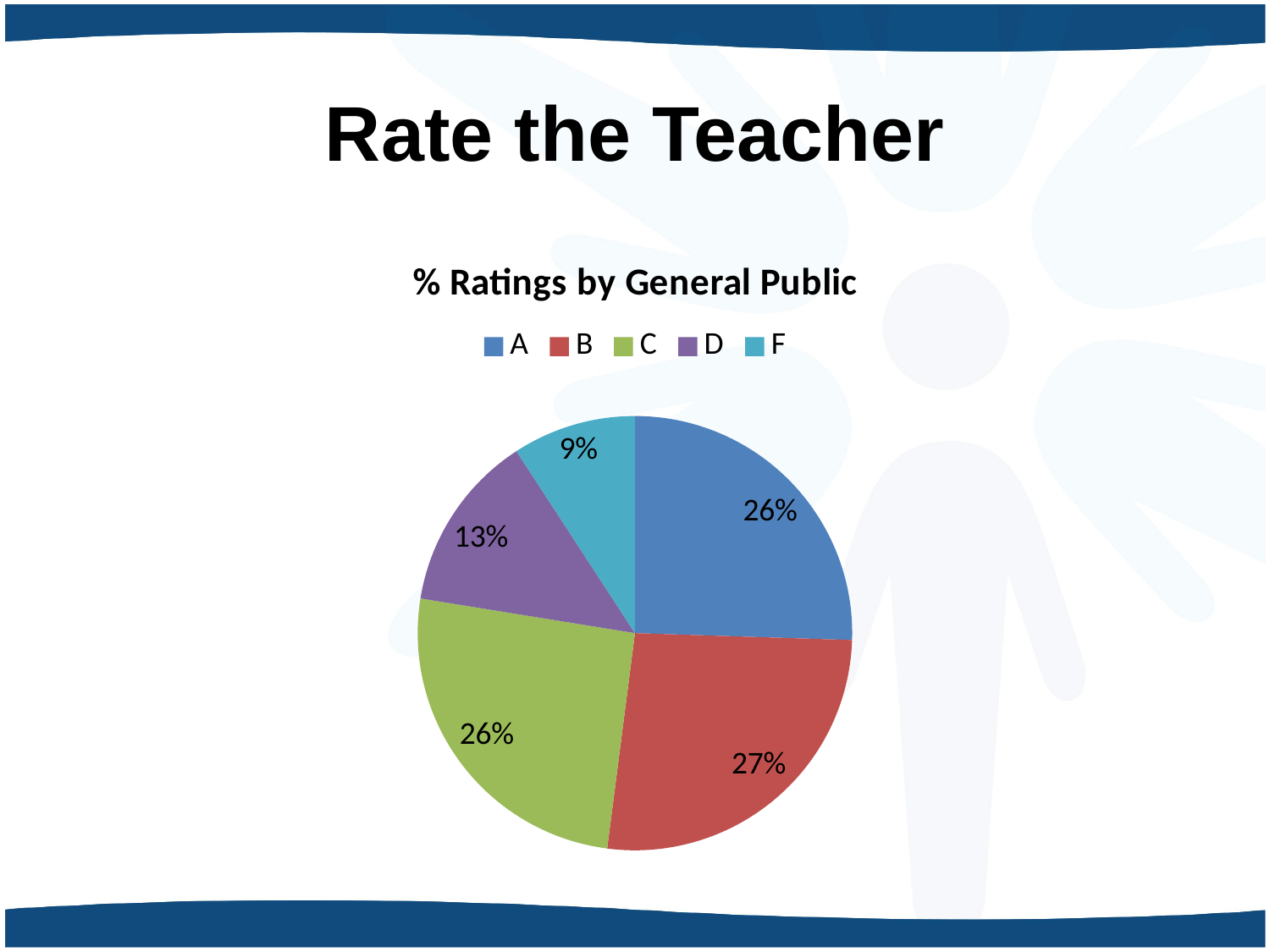
What is the title of the chart? % Ratings by General Public What percentage of ratings is grade D? 13% Which grade has the smallest share of ratings? F What percentage of ratings is grade F? 9% What type of chart is shown on the slide? pie chart How many categories does the legend list? 5 How many slices does the pie chart have? 5 What percentage of ratings is grade C? 26% What percentage of ratings is grade A? 26% What is the difference in percentage points between grade D and grade F? 4 Which is larger, the share for grade D or the share for grade F? D What percentage of ratings is grade B? 27%